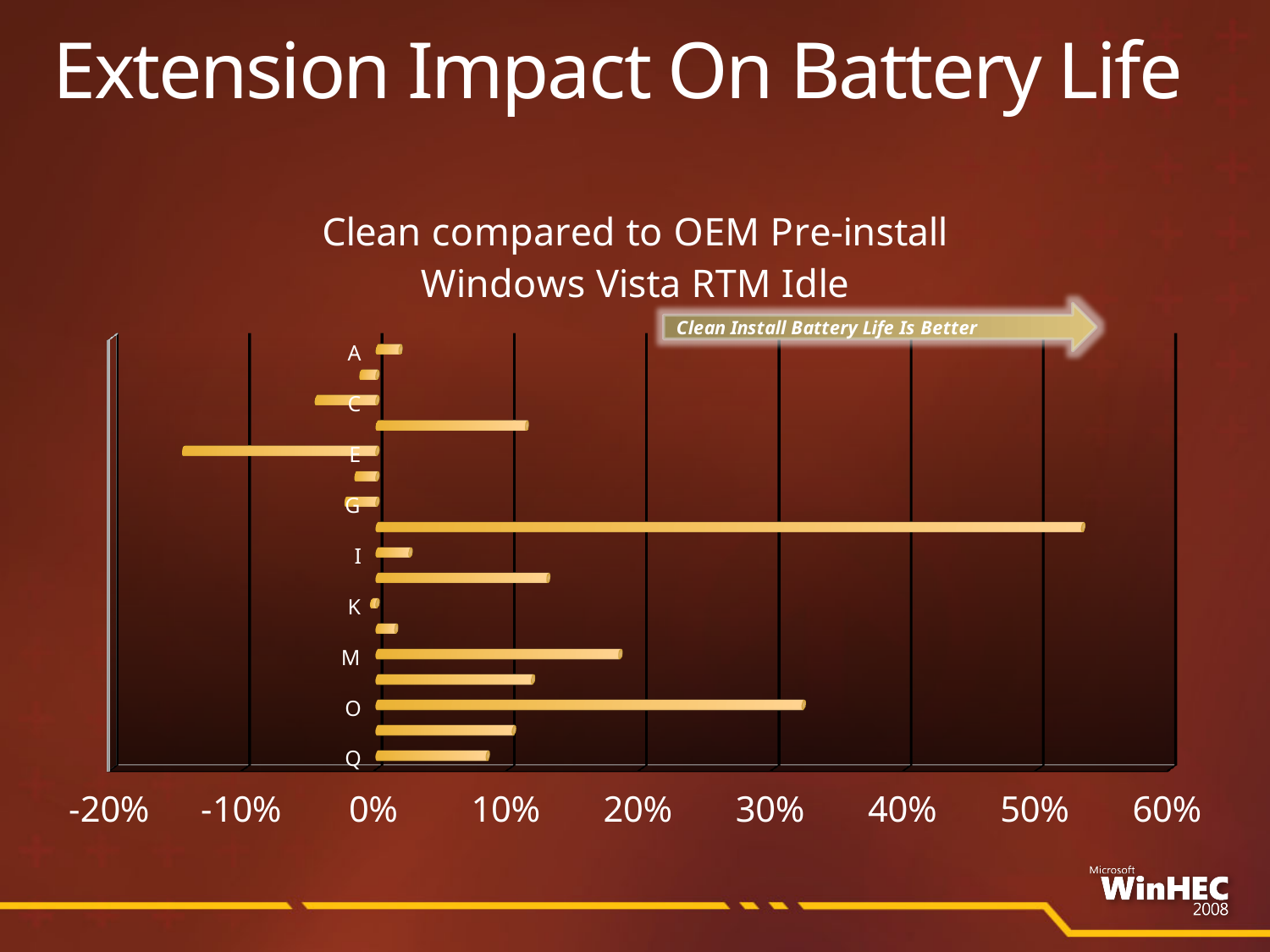
Is the value for M greater or less than 10%? greater Which category has the lowest (most negative) value? E What kind of chart is shown on the slide? Bar chart How many bars are plotted in the chart? 17 What is the title of the chart? Clean compared to OEM Pre-install Windows Vista RTM Idle What does the arrow label above the chart say? Clean Install Battery Life Is Better Which has the larger value, C or E? C Is the value for O greater or less than 20%? greater Which has the larger value, O or M? O Is the value for I greater or less than 10%? less